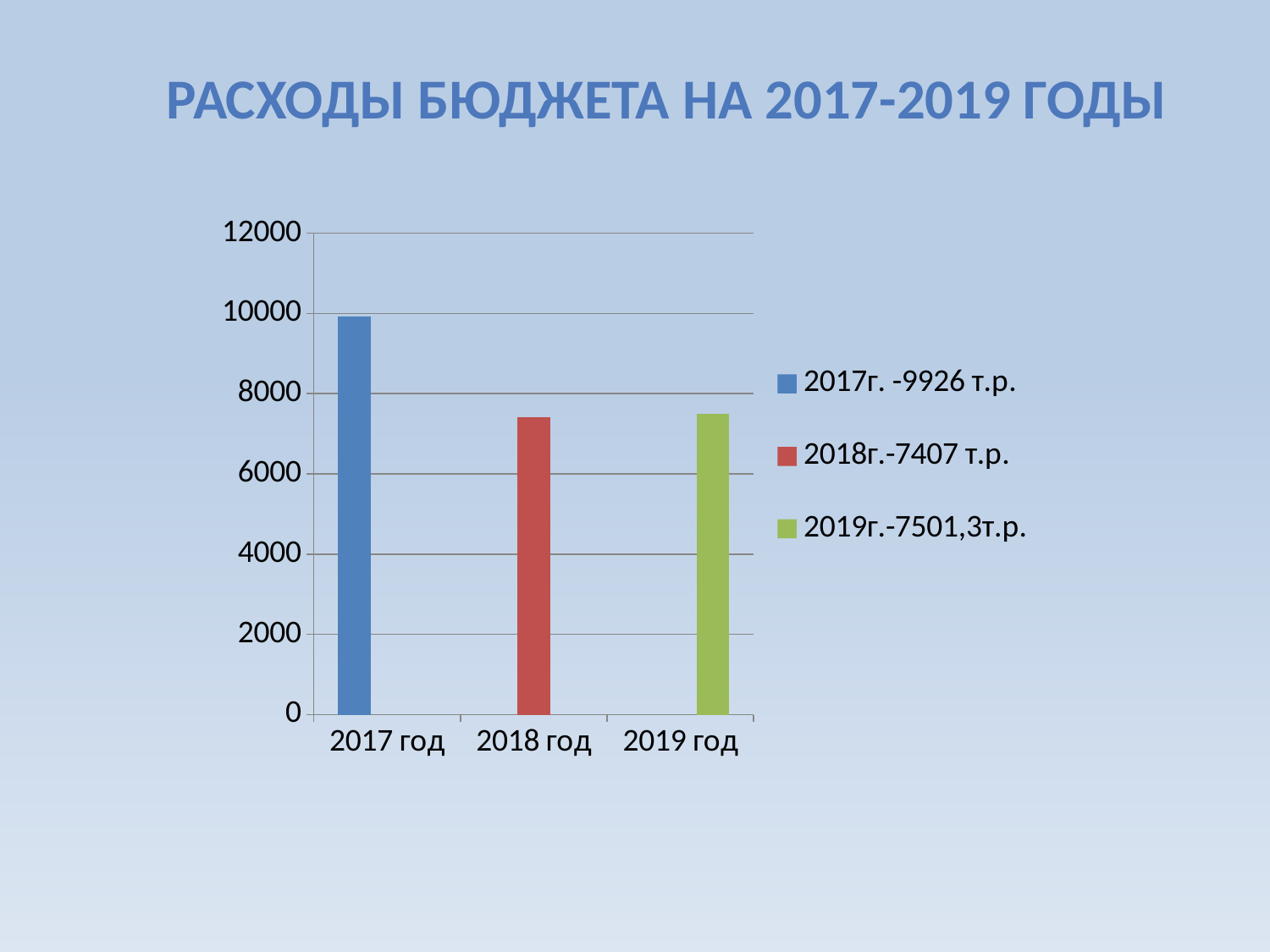
How many entries does the legend list? 3 What is the title of the chart? РАСХОДЫ БЮДЖЕТА НА 2017-2019 ГОДЫ What kind of chart is shown on the slide? bar chart Is the value for 2018 год greater or less than 8000? less According to the legend, what is the budget expenditure value for 2018? 7407 т.р. What colour is the bar for 2019 год? green Which year has the highest budget expenditure? 2017 год According to the legend, what is the budget expenditure value for 2019? 7501,3 т.р. What is the difference between the 2017 and 2018 expenditure values? 2519 т.р. According to the legend, what is the budget expenditure value for 2017? 9926 т.р. How many bars (years) are plotted in the chart? 3 Which year has the lowest budget expenditure? 2018 год